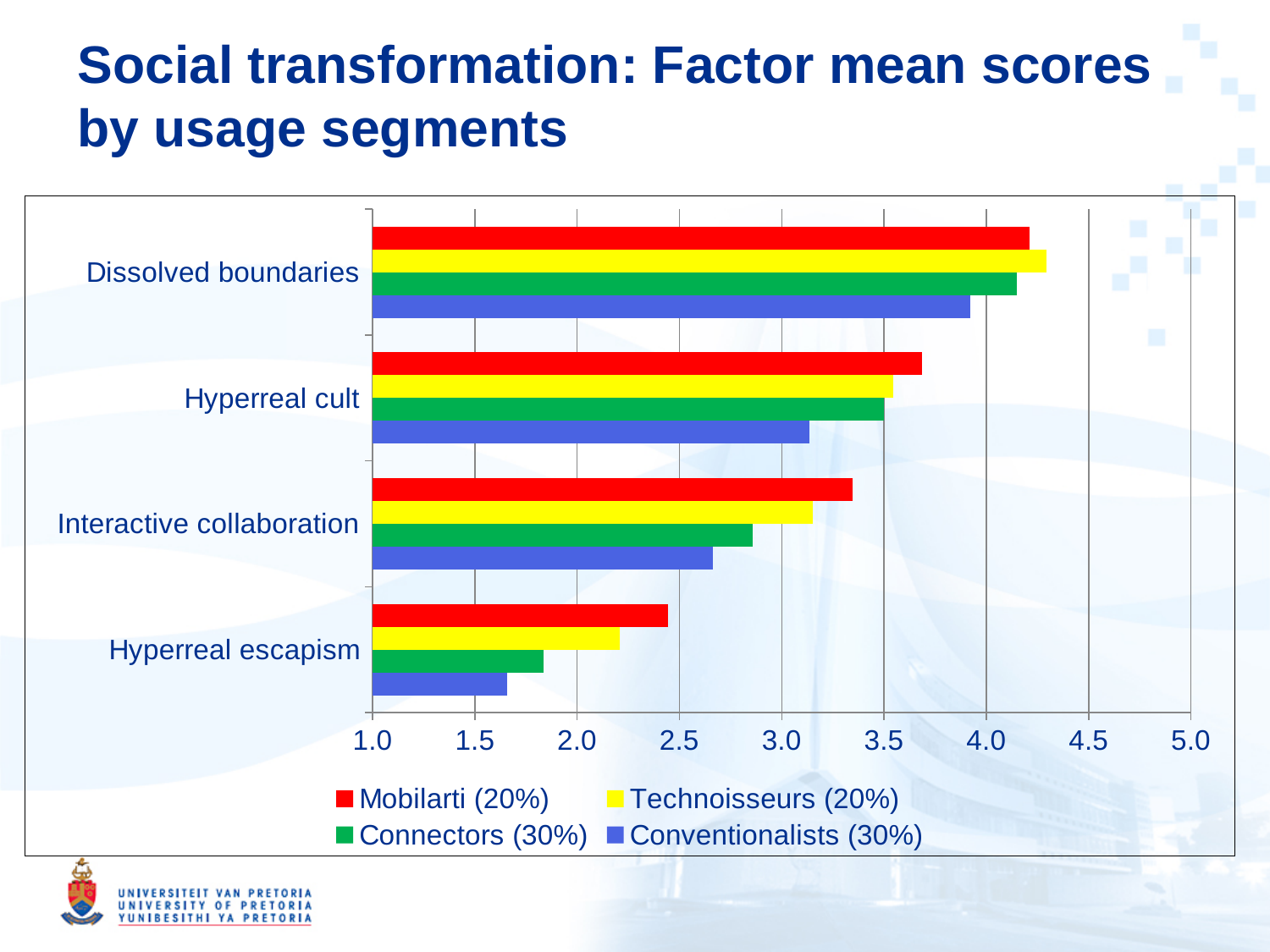
What colour represents Technoisseurs (20%) in the chart? yellow For which factor does Mobilarti (20%) have its highest mean score? Dissolved boundaries Is the value for Connectors (30%) on Interactive collaboration greater or less than 3.0? less How many series does the legend list? 4 For which factor does Conventionalists (30%) have its lowest mean score? Hyperreal escapism On Hyperreal cult, which is larger: the value for Mobilarti (20%) or for Conventionalists (30%)? Mobilarti (20%) What percentage is shown in the legend next to Connectors? 30% Is the value for Mobilarti (20%) on Dissolved boundaries greater or less than 4.0? greater Is the value for Conventionalists (30%) on Hyperreal escapism greater or less than 2.0? less On Interactive collaboration, which is larger: the value for Technoisseurs (20%) or for Connectors (30%)? Technoisseurs (20%) What kind of chart is shown on the slide? bar chart How many factor categories are plotted on the chart? 4